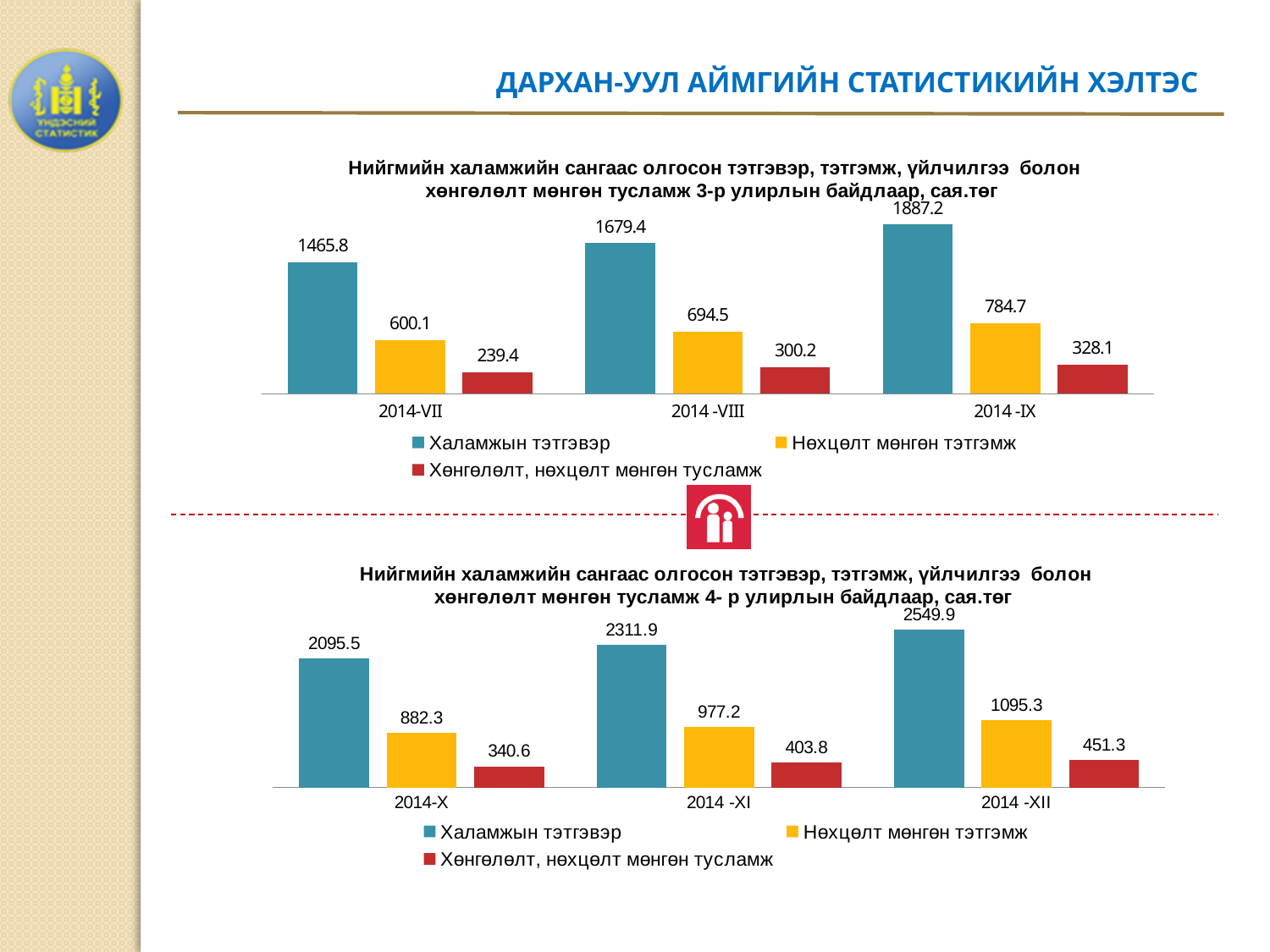
In the top chart (3-р улирлын), what is the value of Нөхцөлт мөнгөн тэтгэмж for 2014-VIII? 694.5 In the top chart (3-р улирлын), what is the value of Хөнгөлөлт, нөхцөлт мөнгөн тусламж for 2014-IX? 328.1 In the bottom chart (4-р улирлын), what is the difference between the Нөхцөлт мөнгөн тэтгэмж values for 2014-XII and 2014-X? 213.0 In the top chart (3-р улирлын), what is the difference between the Халамжын тэтгэвэр values for 2014-IX and 2014-VII? 421.4 In the top chart (3-р улирлын), what is the value of Халамжын тэтгэвэр for 2014-VII? 1465.8 In the top chart (3-р улирлын), how does Халамжын тэтгэвэр change from 2014-VII to 2014-IX? It rises In the bottom chart (4-р улирлын), what is the value of Халамжын тэтгэвэр for 2014-XII? 2549.9 In the bottom chart (4-р улирлын), which month has the lowest value for Нөхцөлт мөнгөн тэтгэмж? 2014-X In the top chart (3-р улирлын), which month has the highest value for Халамжын тэтгэвэр? 2014-IX How many series does the legend of the bottom chart (4-р улирлын) list? 3 In the bottom chart (4-р улирлын), what is the value of Хөнгөлөлт, нөхцөлт мөнгөн тусламж for 2014-X? 340.6 In the bottom chart (4-р улирлын), which is larger: Нөхцөлт мөнгөн тэтгэмж for 2014-XI or Хөнгөлөлт, нөхцөлт мөнгөн тусламж for 2014-XII? Нөхцөлт мөнгөн тэтгэмж for 2014-XI